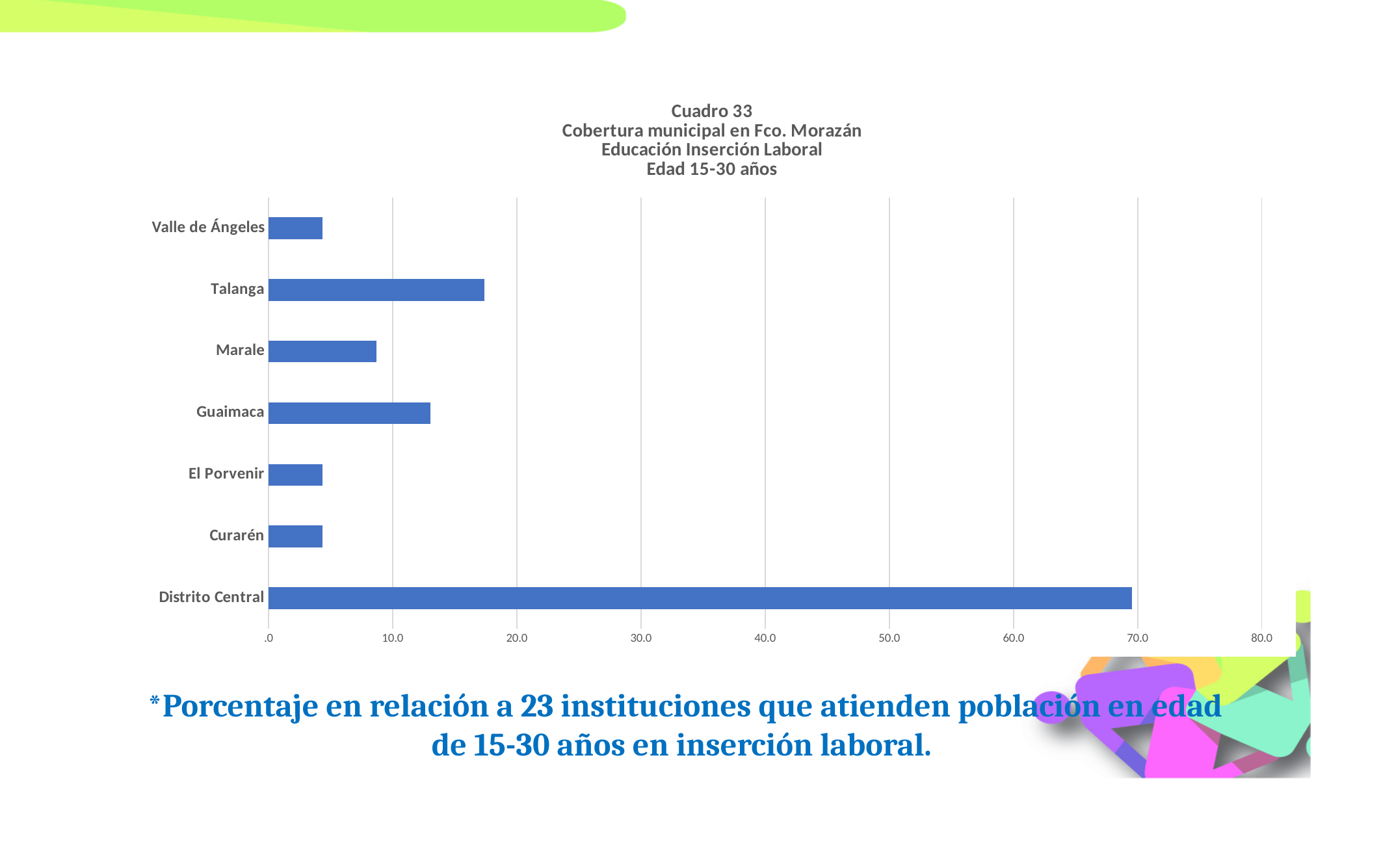
Which municipality has the highest value in the chart? Distrito Central What kind of chart is shown on the slide? bar chart Is the value for Marale greater or less than 10.0? less What is the table number given in the chart title? Cuadro 33 Is the value for Guaimaca greater or less than 10.0? greater Is the value for Talanga greater or less than 20.0? less Which has the larger value, Marale or Guaimaca? Guaimaca How many municipalities are plotted in the chart? 7 Which has the larger value, Talanga or Guaimaca? Talanga